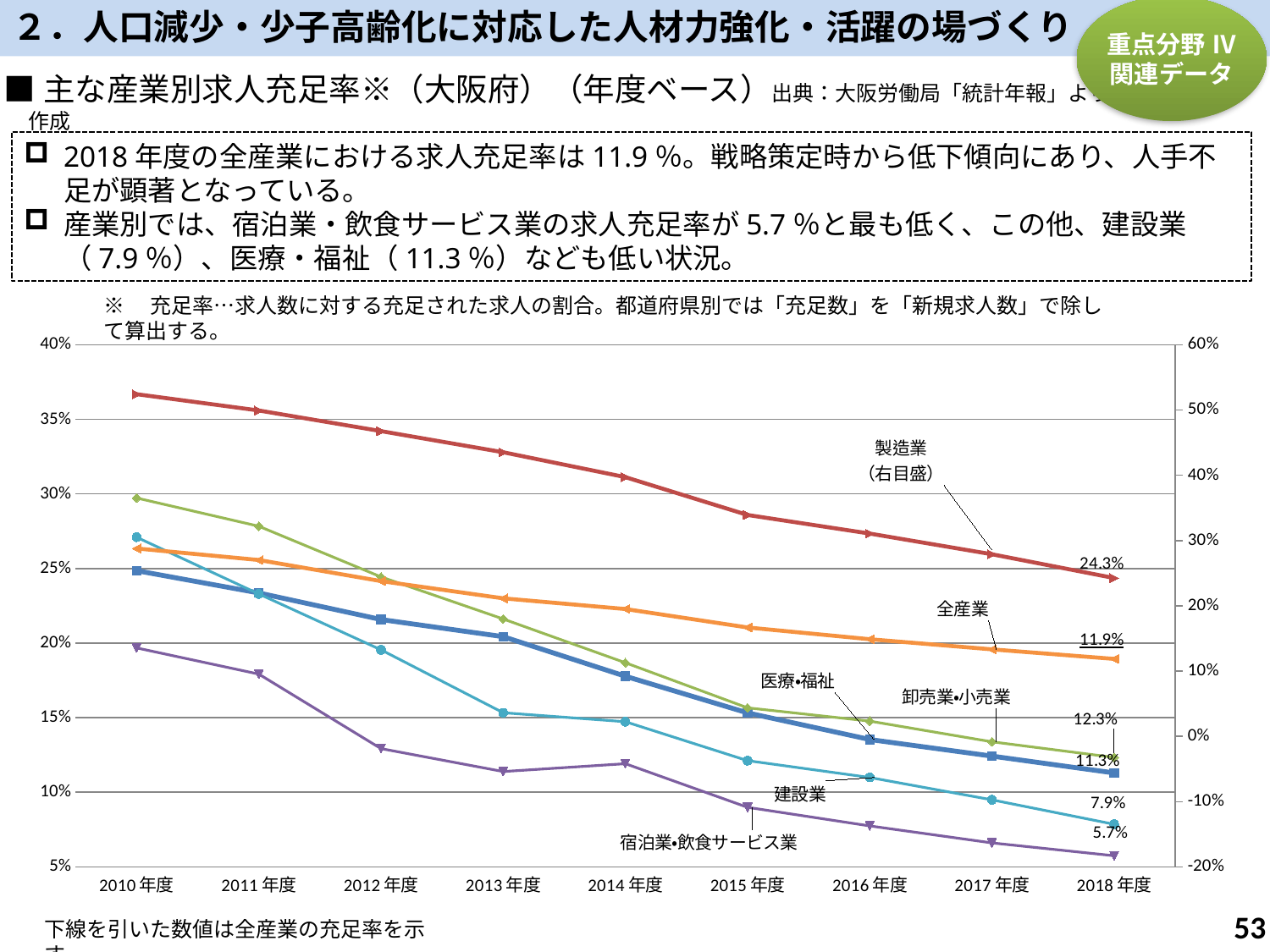
Is the 2010年度 value for 全産業 greater or less than 20%? greater Which series is plotted against the right-hand axis? 製造業 Which industry has the lowest value in 2018年度? 宿泊業・飲食サービス業 What is the difference between 卸売業・小売業 (12.3%) and 医療・福祉 (11.3%) in 2018年度? 1.0% What is the 2018年度 value for 製造業 (right axis)? 24.3% Does the 全産業 line rise or fall from 2010年度 to 2018年度? fall In 2018年度, which is larger: 建設業 or 宿泊業・飲食サービス業? 建設業 What is the 2018年度 value for 全産業? 11.9% What is the 2018年度 value for 建設業? 7.9% How many fiscal years are plotted along the x axis? 9 What is the 2018年度 value for 宿泊業・飲食サービス業? 5.7% What kind of chart is shown on the slide? line chart